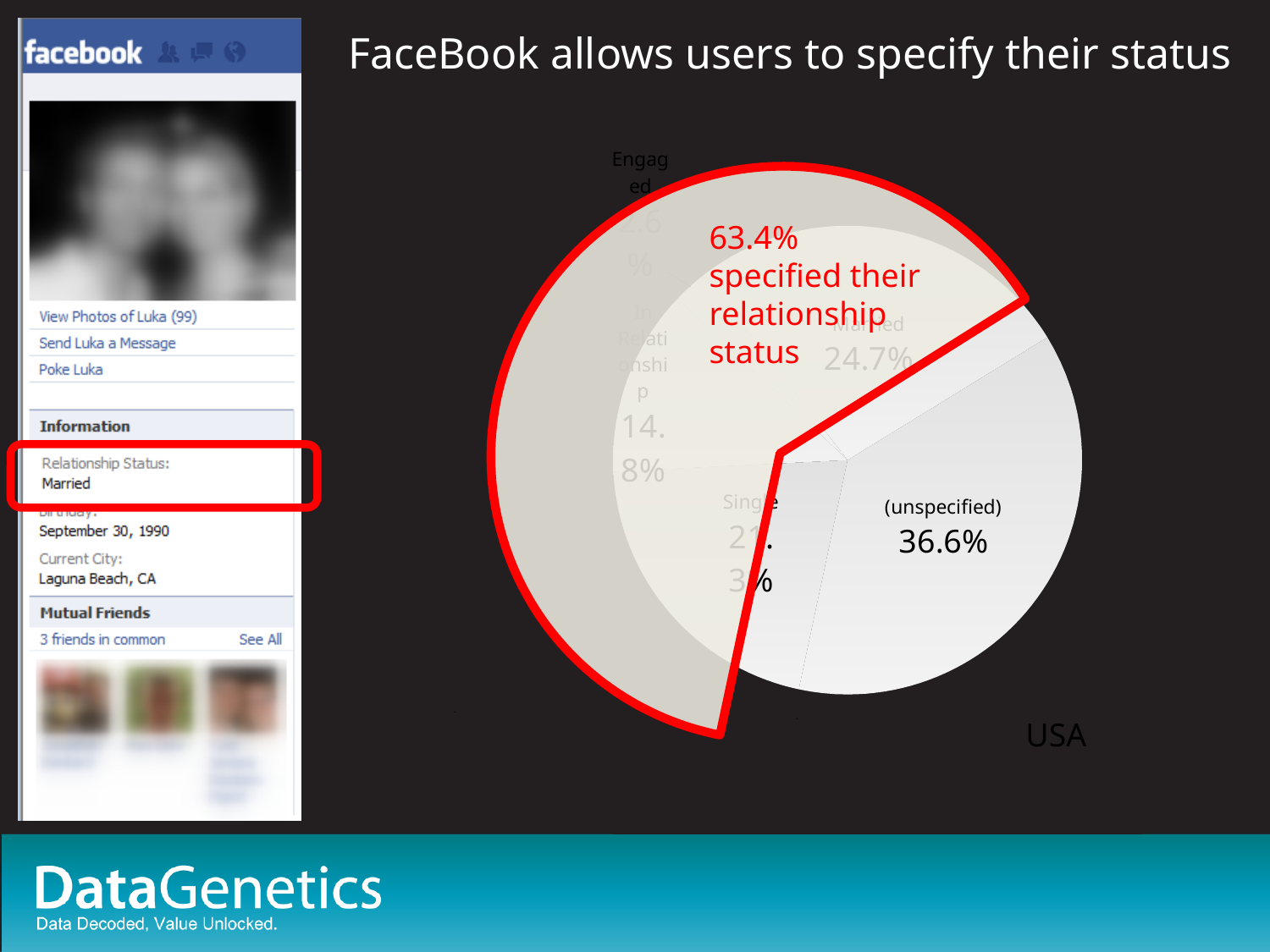
Which country label appears at the bottom right of the pie chart? USA Which is larger, the Married slice or the In Relationship slice? Married How many slices does the pie chart have? 5 According to the red annotation on the chart, what percentage of users specified their relationship status? 63.4% Which slice of the pie is the smallest? Engaged What is the difference between the (unspecified) slice and the Married slice? 11.9% What share of the pie is labelled (unspecified)? 36.6% Which slice of the pie is the largest? (unspecified) What is the value shown for the Engaged slice? 2.6% What kind of chart is shown on the slide? pie chart What is the value shown for the Married slice? 24.7% What is the value shown for the In Relationship slice? 14.8%